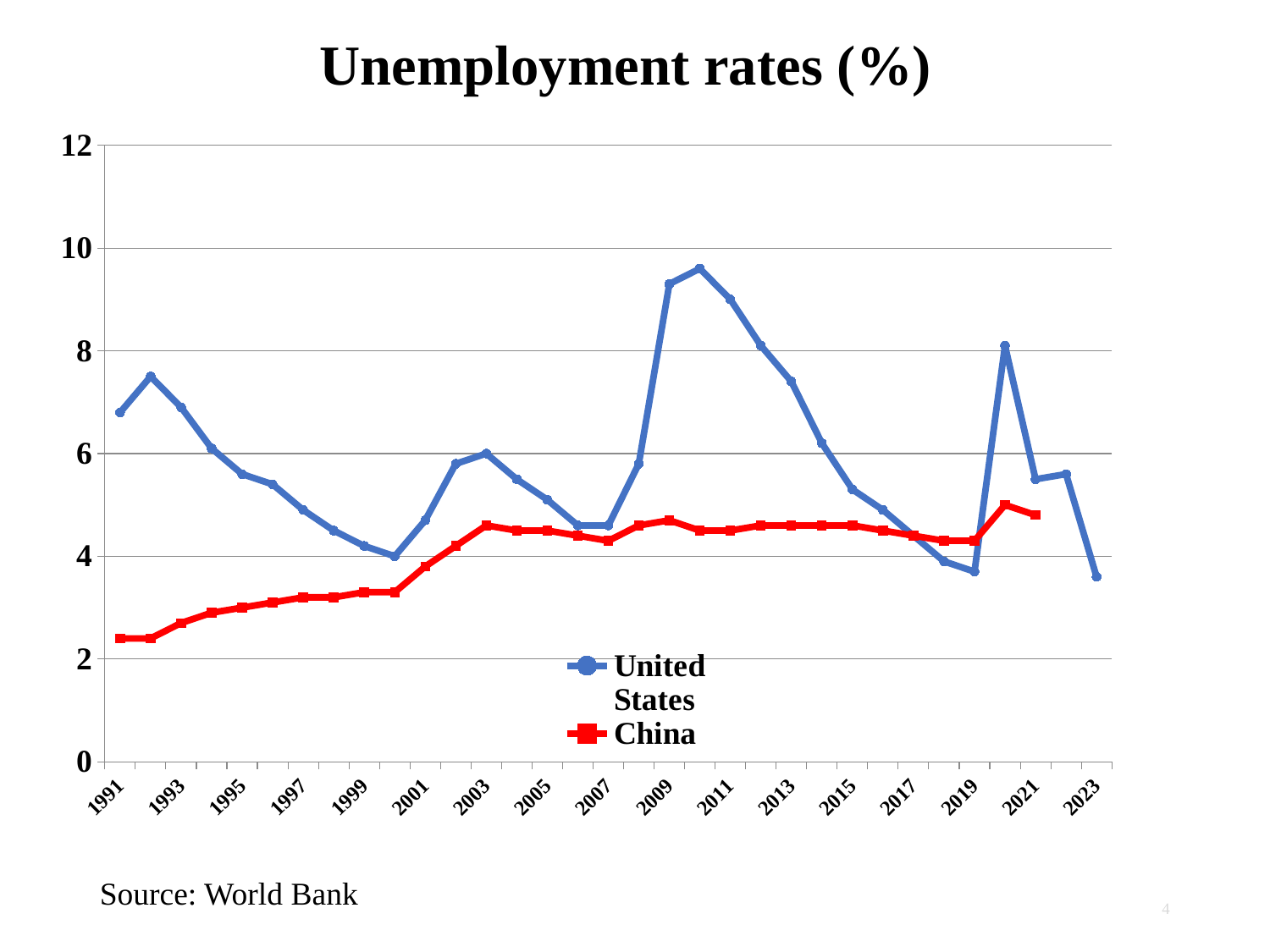
Is the value for the United States in 2010 greater or less than 8? greater How many series does the legend list? 2 What source is cited for the chart data? World Bank What is the title of the chart? Unemployment rates (%) In which year does the United States series reach its highest value? 2010 Is the value for the United States in 2023 greater or less than 4? less Which series has the higher value in 2019, United States or China? China What kind of chart is shown on the slide? Line chart Which series has the higher value in 2010, United States or China? United States Does the China series rise or fall from 1991 to 2003? rise Is the value for the United States in 2020 greater or less than 6? greater